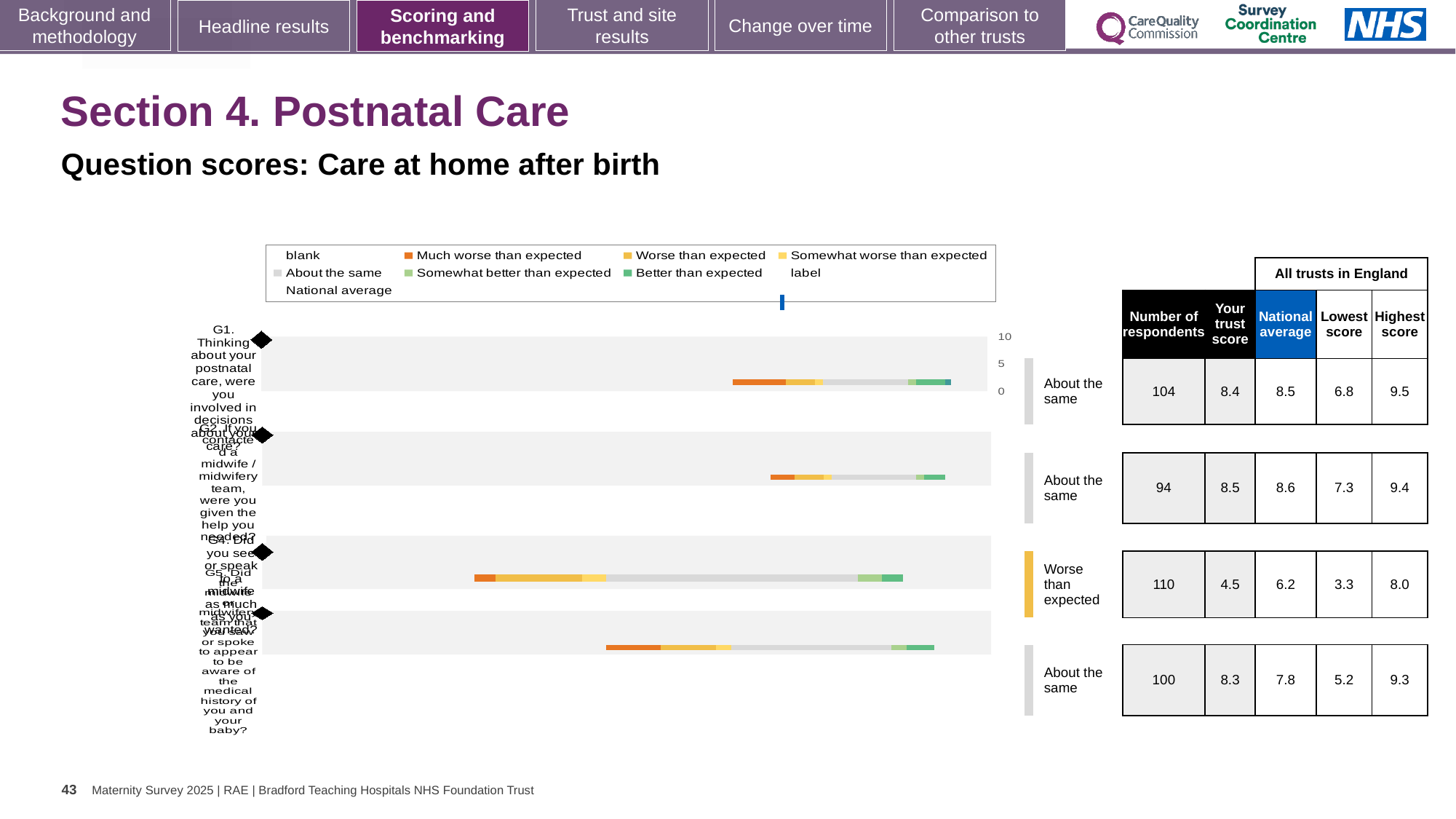
What is the highest value shown on the chart's axis? 10 How many entries does the chart legend list? 9 Which rating label is shown next to the first bar (G1)? About the same Which legend entry is shown in dark green? Better than expected How many bars (questions) are plotted in the chart? 4 Which legend entry is shown in orange? Much worse than expected What kind of chart is shown on the slide? bar chart Which rating label is shown next to the third bar (G4)? Worse than expected How many of the four bars are labelled 'About the same'? 3